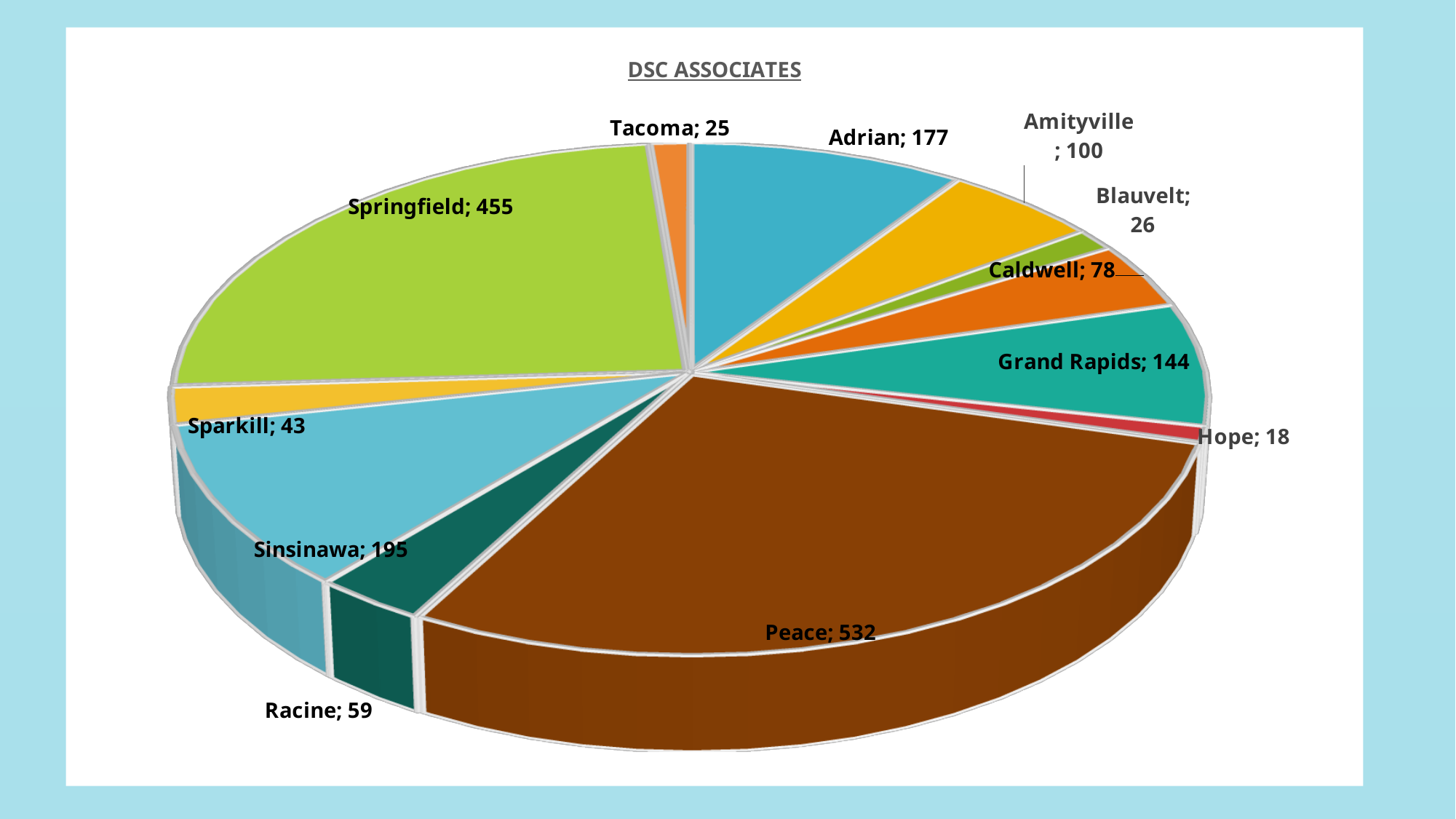
Which category has the smallest value? Hope What is the value for Grand Rapids? 144 How many slices does the pie chart have? 12 What is the value for Amityville? 100 What is the title of the chart? DSC ASSOCIATES What type of chart is shown on the slide? Pie chart What is the difference between the values for Caldwell and Blauvelt? 52 Which category has the largest value? Peace What is the value for Sparkill? 43 What is the value for Peace? 532 Which is larger, the value for Adrian or the value for Sinsinawa? Sinsinawa What is the difference between the values for Peace and Springfield? 77